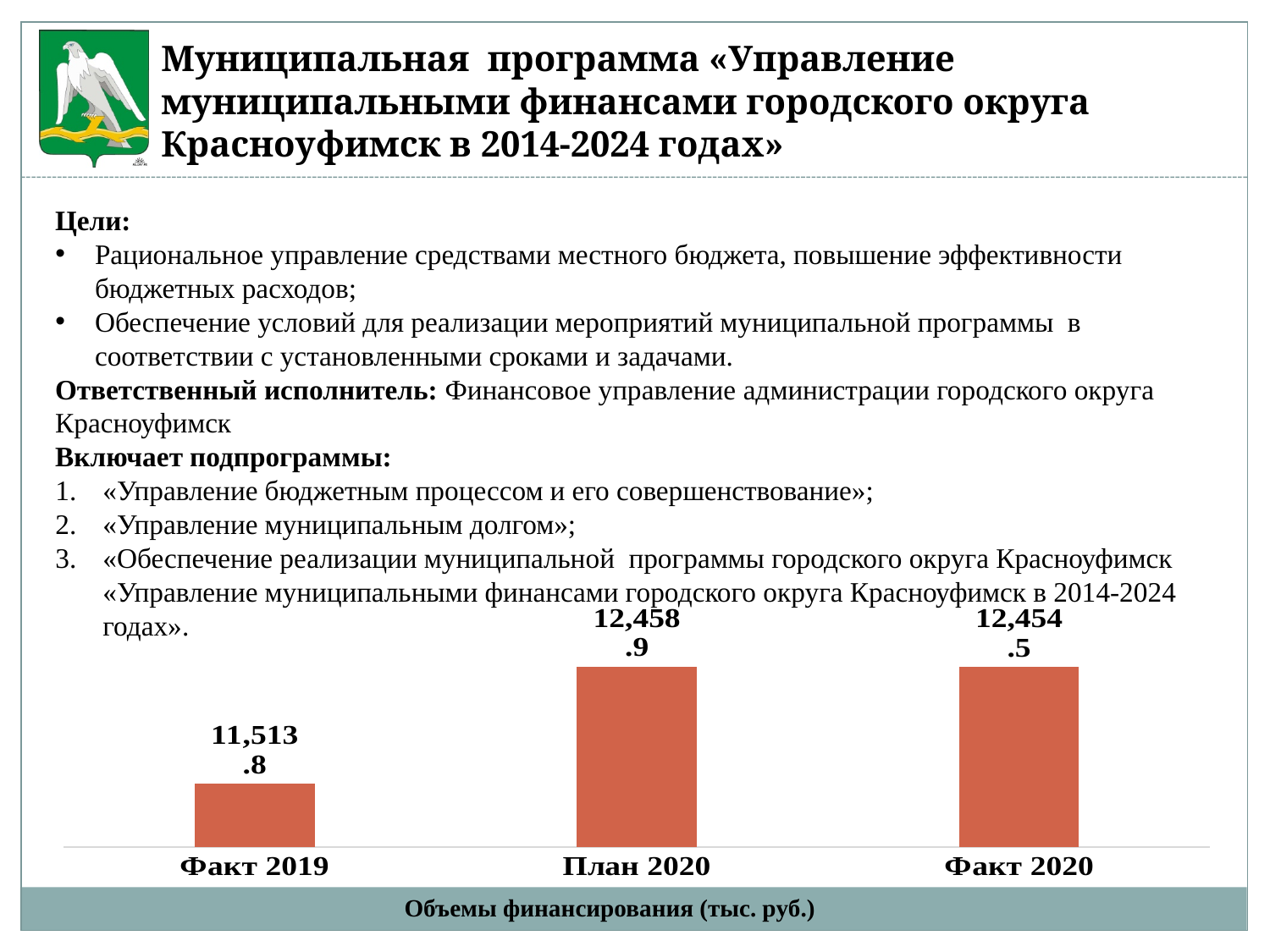
What is the difference between the values for План 2020 and Факт 2019? 945.1 What is the difference between the values for План 2020 and Факт 2020? 4.4 Which is larger, the value for Факт 2019 or the value for Факт 2020? Факт 2020 How many categories are shown in the bar chart? 3 What is the value for План 2020 in the bar chart? 12,458.9 What caption is shown below the bar chart? Объемы финансирования (тыс. руб.) What is the value for Факт 2020 in the bar chart? 12,454.5 What is the value for Факт 2019 in the bar chart? 11,513.8 What is the difference between the values for Факт 2020 and Факт 2019? 940.7 Which category has the lowest value in the bar chart? Факт 2019 Which category has the highest value in the bar chart? План 2020 What type of chart is shown on the slide? bar chart